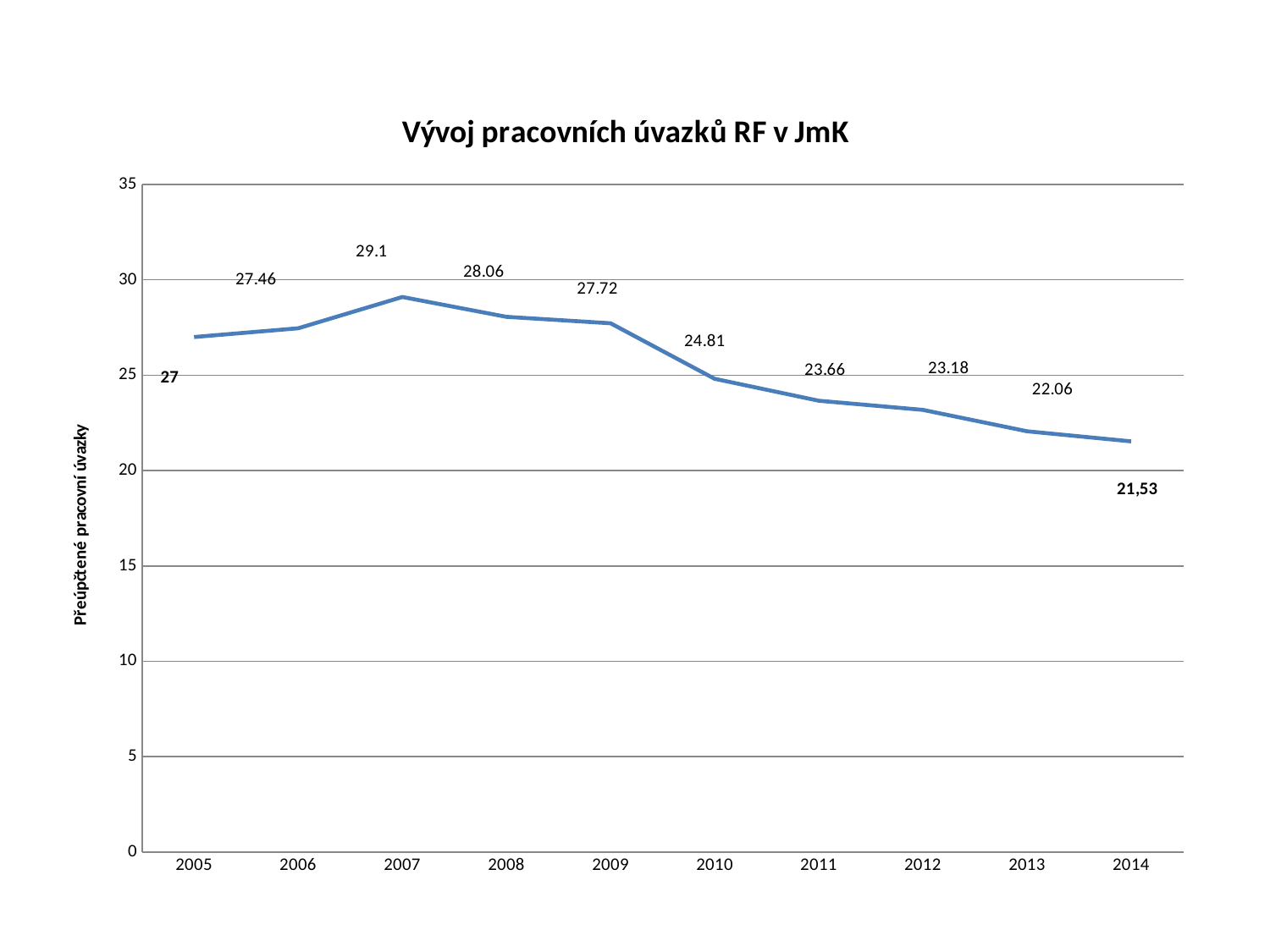
What is the value for 2014? 21,53 What is the value for 2007? 29.1 What is the value for 2010? 24.81 Which year has the highest value? 2007 How many years are plotted on the x axis? 10 What is the title of the chart? Vývoj pracovních úvazků RF v JmK Do the values rise or fall from 2009 to 2014? fall Which year has the lowest value? 2014 Which is larger, the value for 2006 or the value for 2009? 2009 What kind of chart is this? line chart Is the value for 2013 greater or less than 25? less What is the difference between the values for 2007 and 2008? 1.04